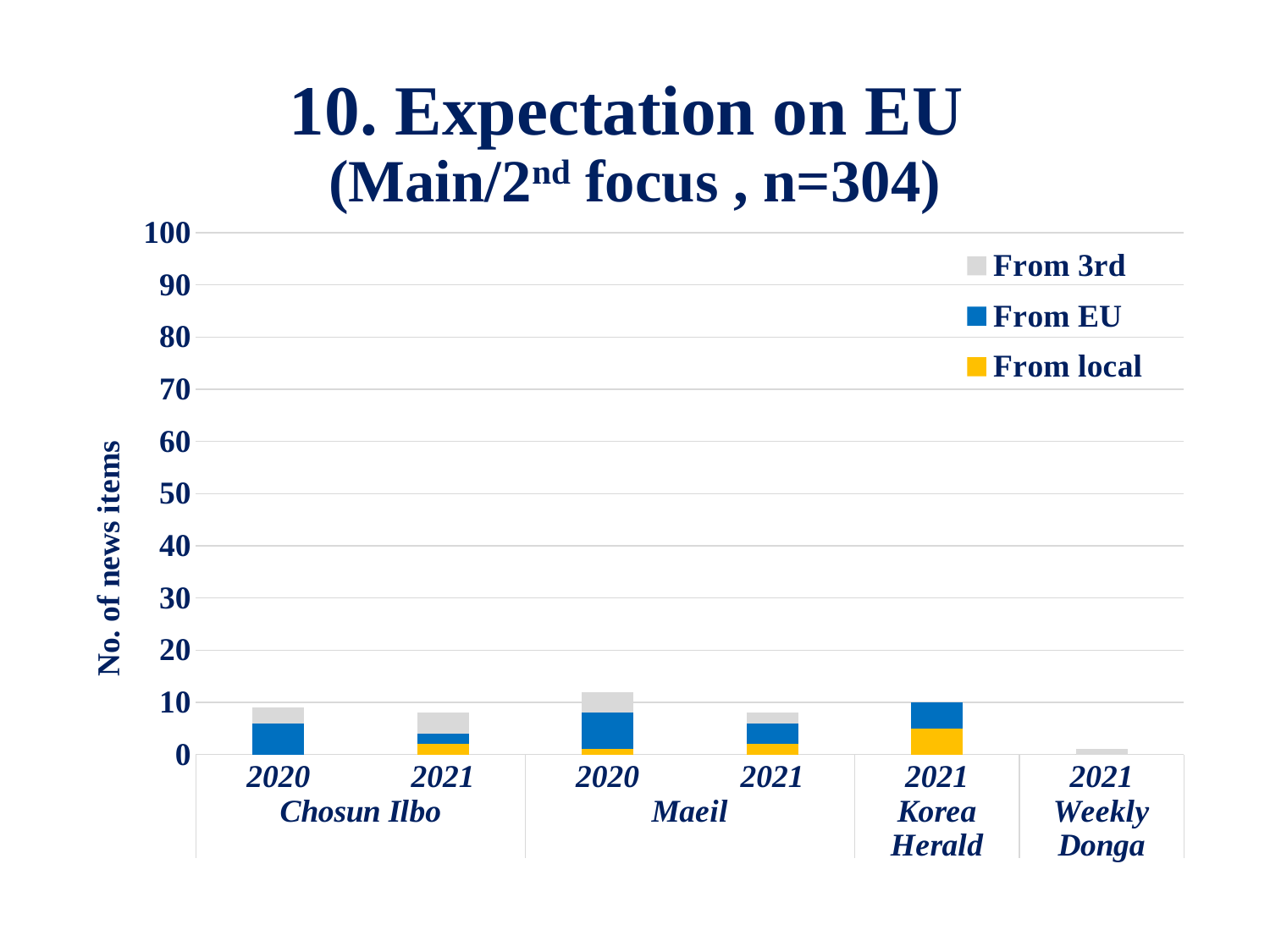
What kind of chart is shown on the slide? stacked bar chart What is the label on the vertical axis? No. of news items Is the total for Chosun Ilbo 2020 greater or less than 20? less How many series does the legend list? 3 Is the total for Weekly Donga 2021 greater or less than 10? less What are the three series named in the legend? From 3rd, From EU, From local How many bars are plotted in the chart? 6 Which bar has the highest total? Maeil 2020 Which bar has the lowest total? Weekly Donga 2021 Which is larger, the total for Korea Herald 2021 or the total for Weekly Donga 2021? Korea Herald 2021 Which is larger, the total for Maeil 2020 or the total for Weekly Donga 2021? Maeil 2020 Is the total for Maeil 2020 greater or less than 20? less